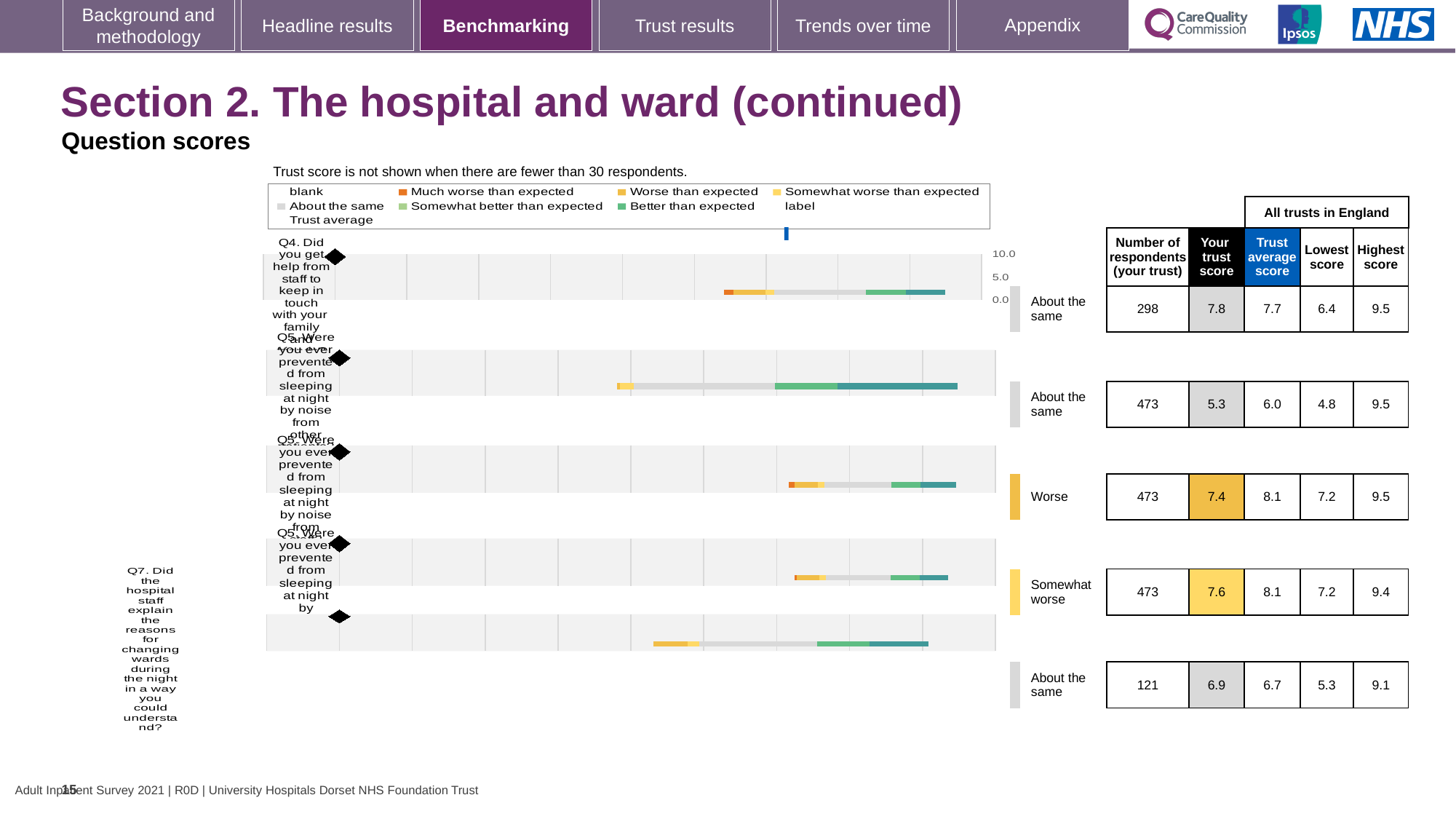
What benchmark category is shown for the third row of the chart? Worse Which row has the highest 'Your trust score' in the table? Q4 (7.8) What is the trust score for Q7 (explaining reasons for changing wards during the night)? 6.9 Which row has the lowest 'Your trust score' in the table? the second row (5.3) What is the difference between the trust average score and the trust score for the third row (7.4 vs 8.1)? 0.7 How many respondents answered Q4 (help from staff to keep in touch with family and friends) at this trust? 298 What is the trust score for Q4 (help from staff to keep in touch with family and friends)? 7.8 What is the trust average score for Q4 (help from staff to keep in touch with family and friends)? 7.7 Is the trust score for Q4 larger or smaller than the trust average score for Q4? larger What is the highest score across all trusts in England for Q7 (explaining reasons for changing wards during the night)? 9.1 What kind of chart is shown on the slide? bar chart How many question rows are plotted in the chart? 5